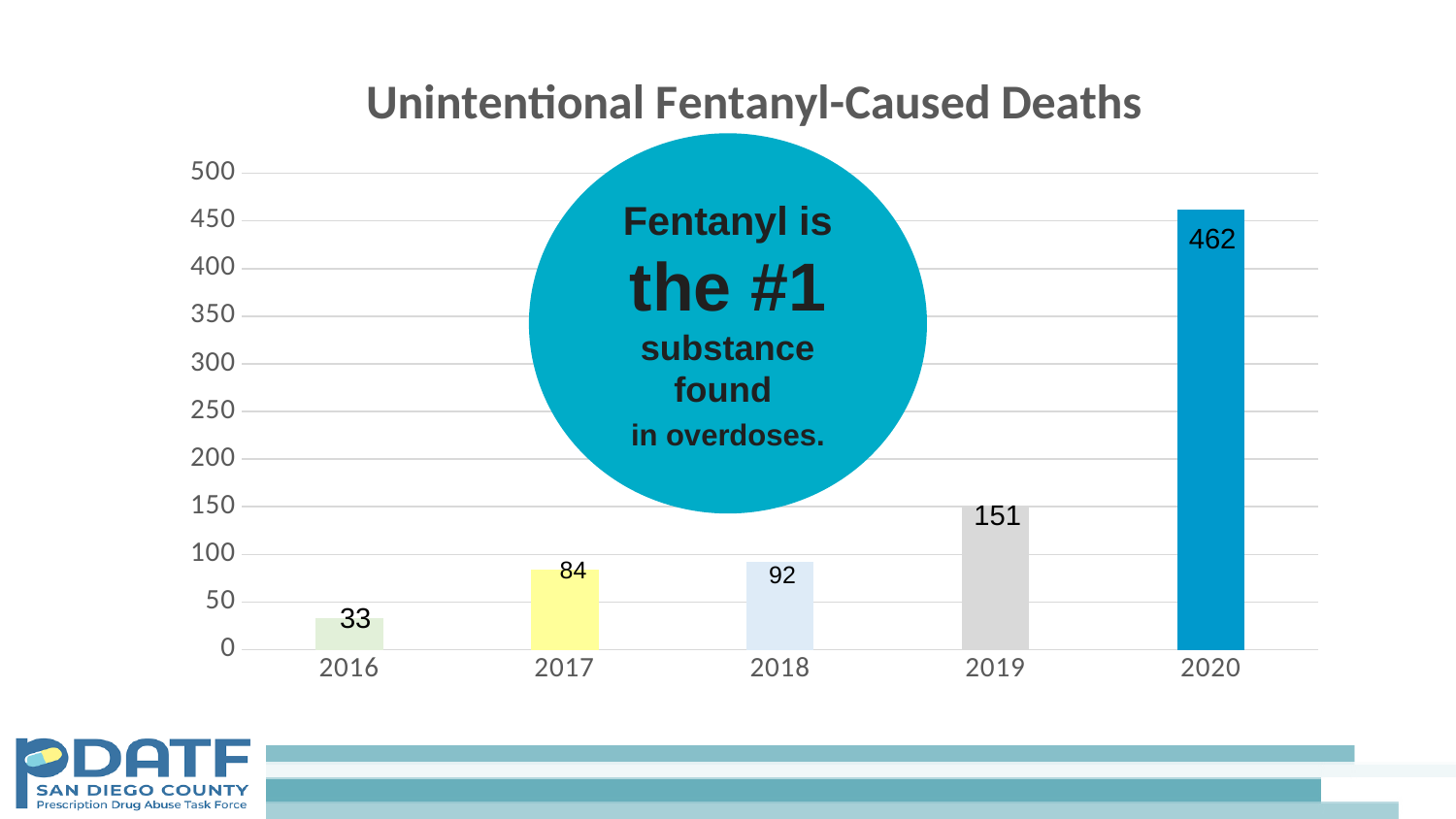
Which year has the highest value? 2020 Is the value for 2019 greater or less than 100? greater What is the difference between the values for 2018 and 2017? 8 Which year has the lowest value? 2016 How many years are shown on the x axis? 5 Do the values rise or fall from 2016 to 2020? rise What is the value for 2018? 92 What is the value for 2016? 33 What is the value for 2020? 462 What kind of chart is this? bar chart What is the difference between the values for 2020 and 2019? 311 Which is larger, the value for 2019 or the value for 2018? 2019